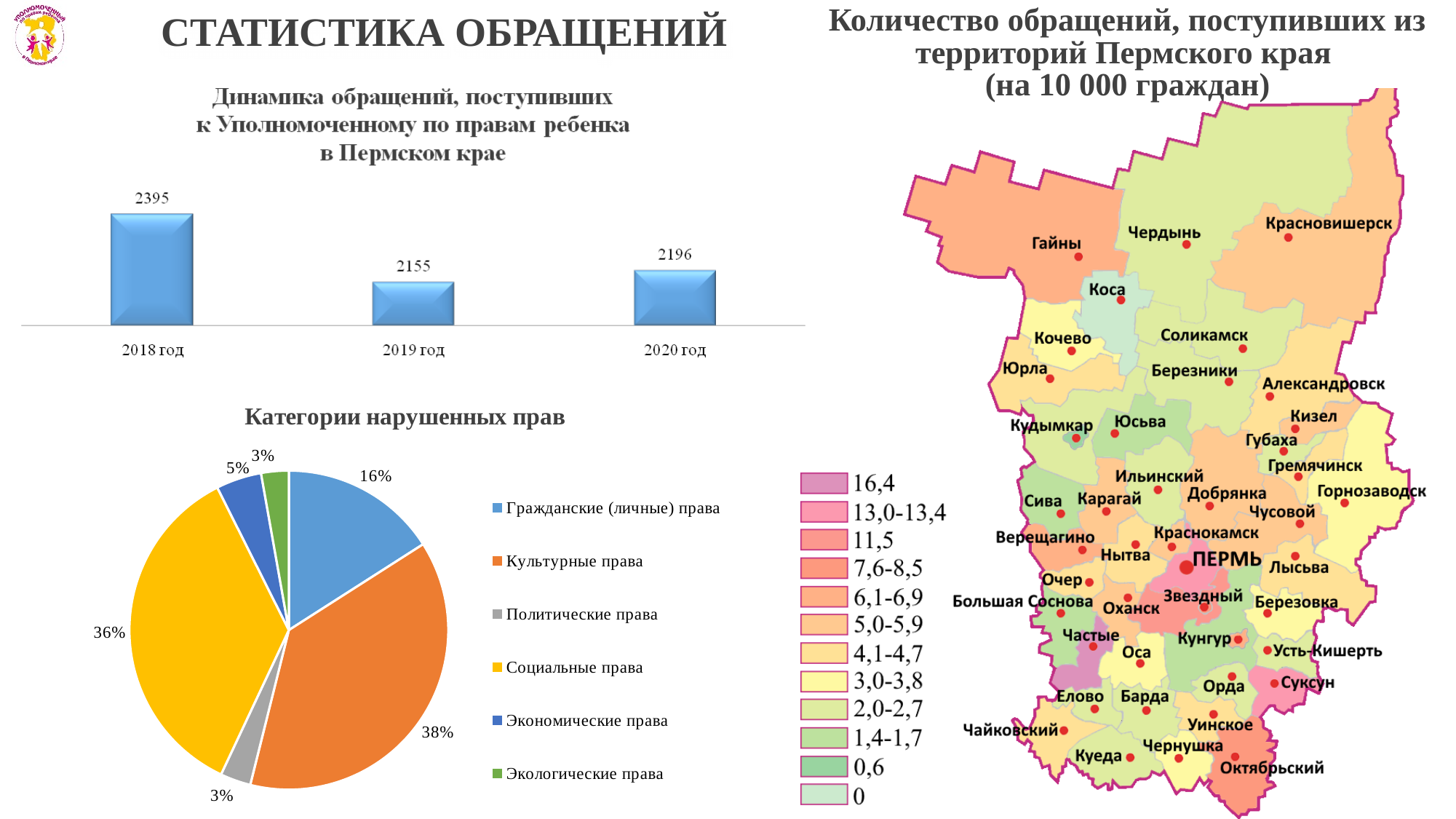
In the bar chart "Динамика обращений, поступивших к Уполномоченному по правам ребенка в Пермском крае", which year has the lowest value? 2019 год In the pie chart "Категории нарушенных прав", what share do Экономические права have? 5% In the pie chart "Категории нарушенных прав", which category has the largest share? Культурные права In the bar chart "Динамика обращений, поступивших к Уполномоченному по правам ребенка в Пермском крае", which year has the highest value? 2018 год In the bar chart "Динамика обращений, поступивших к Уполномоченному по правам ребенка в Пермском крае", how many years are shown? 3 In the pie chart "Категории нарушенных прав", how many categories does the legend list? 6 In the pie chart "Категории нарушенных прав", which is larger: Гражданские (личные) права or Экономические права? Гражданские (личные) права In the bar chart "Динамика обращений, поступивших к Уполномоченному по правам ребенка в Пермском крае", what is the value for 2018 год? 2395 What kind of chart is "Динамика обращений, поступивших к Уполномоченному по правам ребенка в Пермском крае"? bar chart In the pie chart "Категории нарушенных прав", what share do Социальные права have? 36% In the bar chart "Динамика обращений, поступивших к Уполномоченному по правам ребенка в Пермском крае", what is the value for 2020 год? 2196 In the bar chart "Динамика обращений, поступивших к Уполномоченному по правам ребенка в Пермском крае", what is the difference between the values for 2018 год and 2019 год? 240